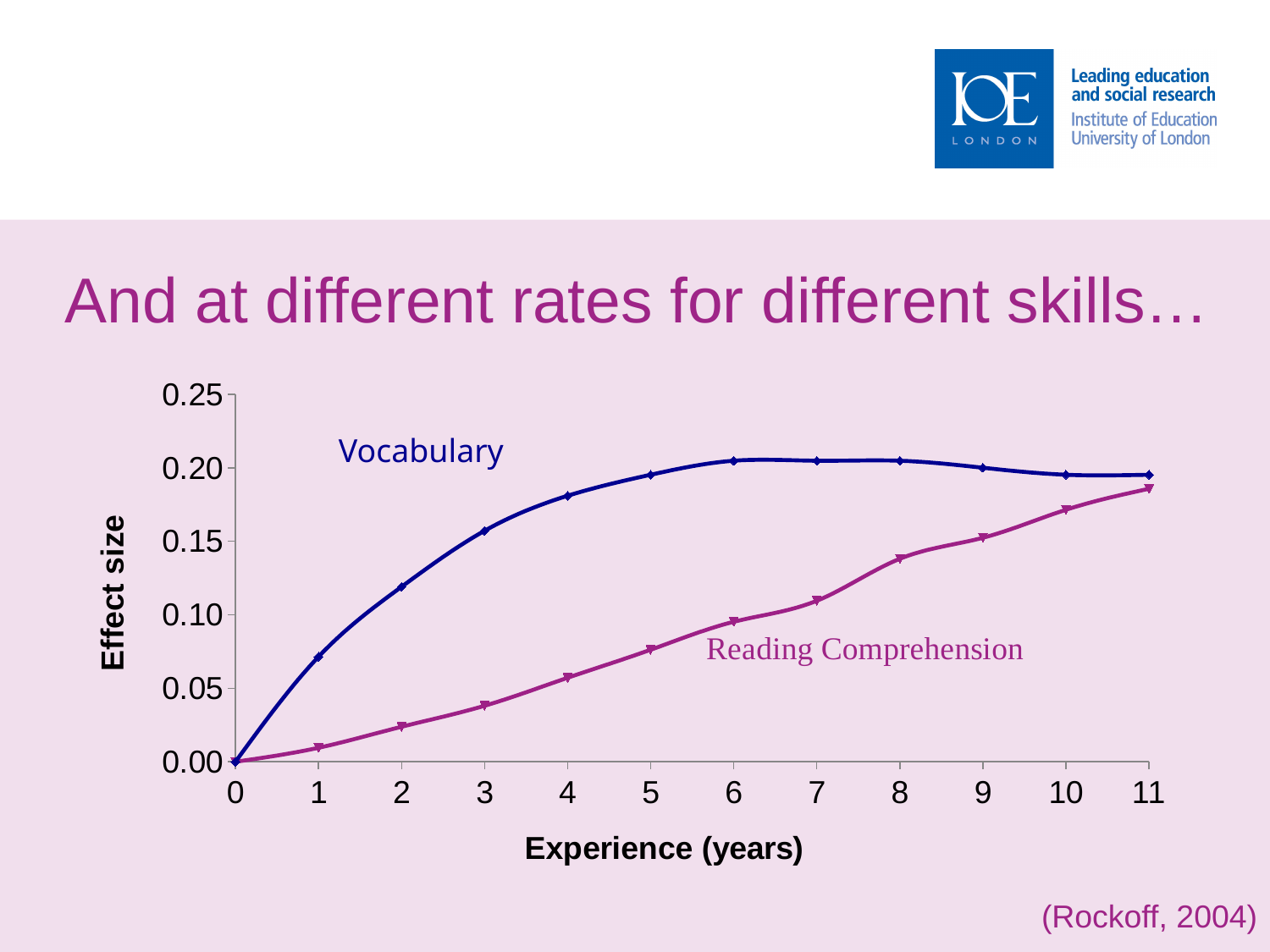
Is the effect size for Reading Comprehension at 10 years of experience greater or less than 0.15? greater At 5 years of experience, which series has the larger effect size, Vocabulary or Reading Comprehension? Vocabulary What is the label of the x axis? Experience (years) How many data points does each line have along the x axis (0 to 11 years)? 12 How many series are plotted on the chart? 2 What kind of chart is shown on the slide? line chart What is the effect size for Vocabulary at 0 years of experience? 0.00 Is the effect size for Vocabulary at 4 years of experience greater or less than 0.15? greater What is the label of the y axis? Effect size Is the effect size for Vocabulary at 2 years of experience greater or less than 0.10? greater Does the Reading Comprehension line rise or fall as experience increases from 0 to 11 years? rise